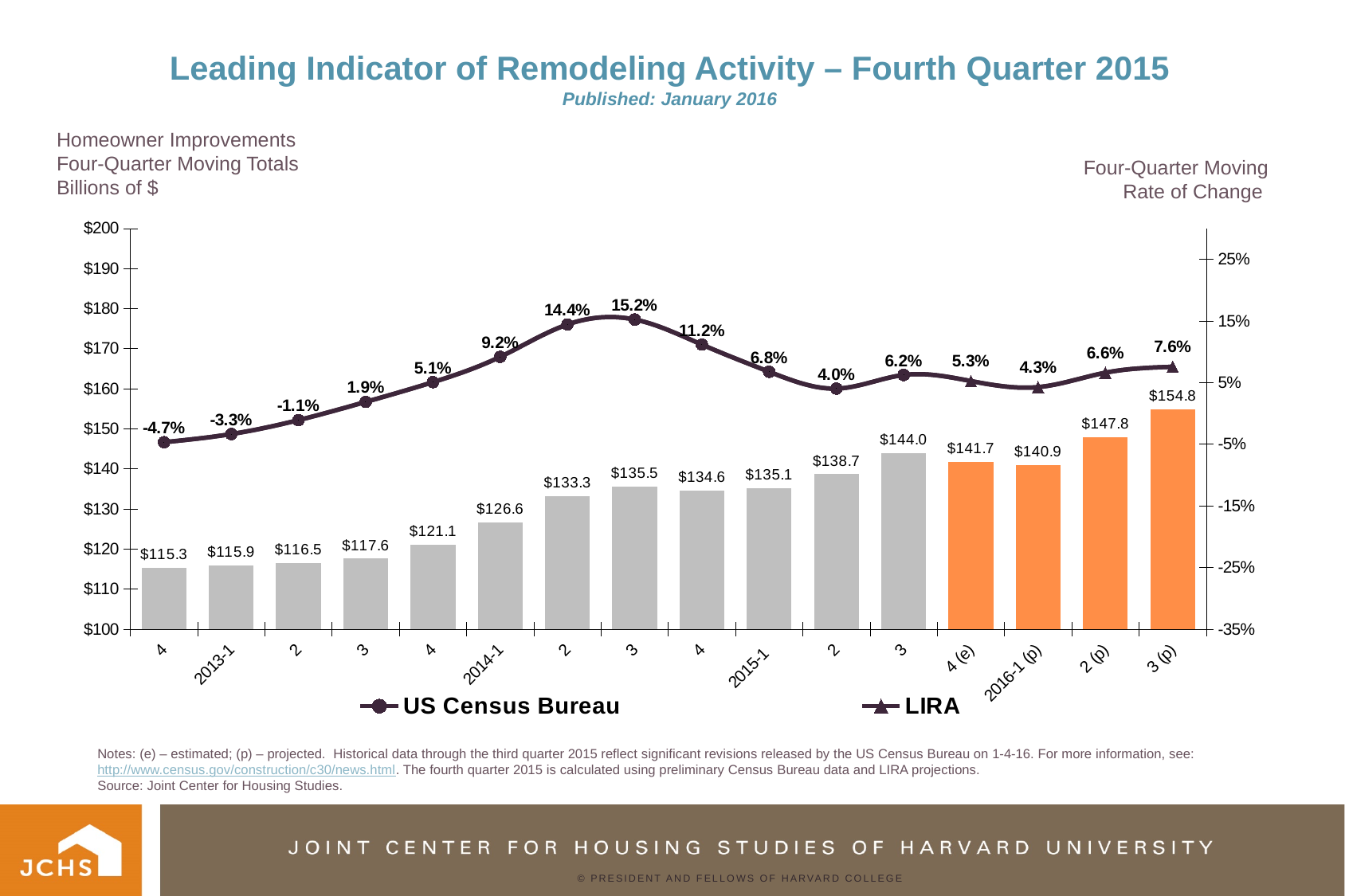
Which quarter has the highest four-quarter moving rate of change? 2014-3, 15.2% What is the difference between the projected totals for 3 (p) and 2 (p) in 2016? $7.0 What is the four-quarter moving rate of change shown for 2014-3? 15.2% What kind of chart is shown on the slide? Combination bar and line chart What is the lowest rate of change shown on the line? -4.7% How many bars are plotted on the chart? 16 What is the four-quarter moving total for 2015-3? $144.0 Which quarter has the highest four-quarter moving total bar? 3 (p) (2016 Q3 projected), $154.8 Does the rate of change line rise or fall from 2014-3 to 2015-2? Fall What is the projected four-quarter moving total for 2016-1 (p)? $140.9 Which is larger, the four-quarter moving total for 2014-4 or for 2015-1? 2015-1 How many series does the legend list? 2